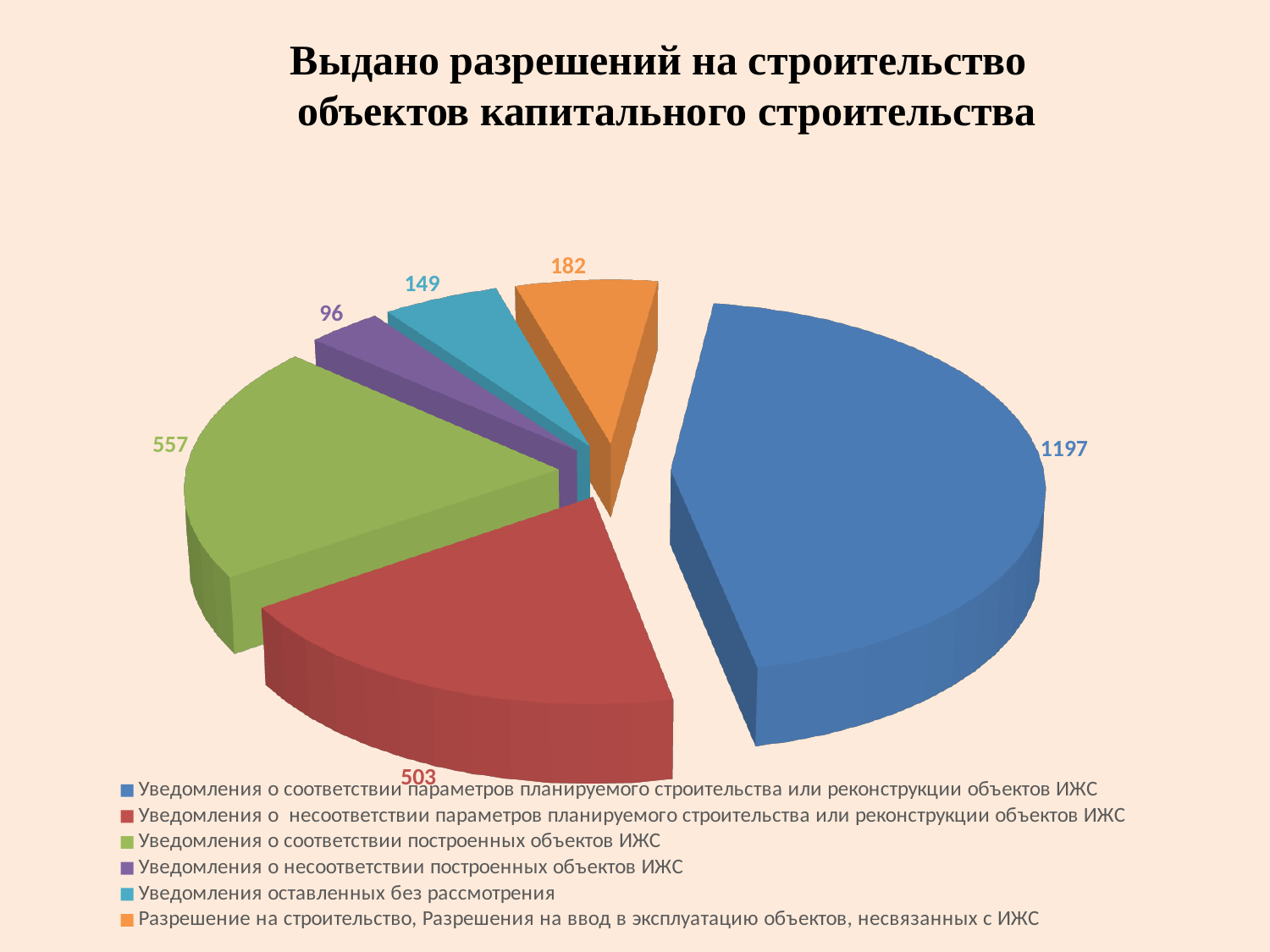
What is the value for 'Уведомления о несоответствии параметров планируемого строительства или реконструкции объектов ИЖС'? 503 Which category has the largest slice in the pie chart? Уведомления о соответствии параметров планируемого строительства или реконструкции объектов ИЖС Which is larger: the value for 'Разрешение на строительство, Разрешения на ввод в эксплуатацию объектов, несвязанных с ИЖС' or the value for 'Уведомления оставленных без рассмотрения'? Разрешение на строительство, Разрешения на ввод в эксплуатацию объектов, несвязанных с ИЖС What is the value for 'Уведомления оставленных без рассмотрения'? 149 How many entries does the legend list? 6 What is the value for 'Уведомления о соответствии параметров планируемого строительства или реконструкции объектов ИЖС'? 1197 Which category has the smallest slice in the pie chart? Уведомления о несоответствии построенных объектов ИЖС What is the title of the chart? Выдано разрешений на строительство объектов капитального строительства What type of chart is shown on the slide? pie chart How many slices does the pie chart have? 6 What is the value for 'Уведомления о соответствии построенных объектов ИЖС'? 557 What is the difference between the values for 'Уведомления о соответствии построенных объектов ИЖС' and 'Уведомления о несоответствии параметров планируемого строительства или реконструкции объектов ИЖС'? 54